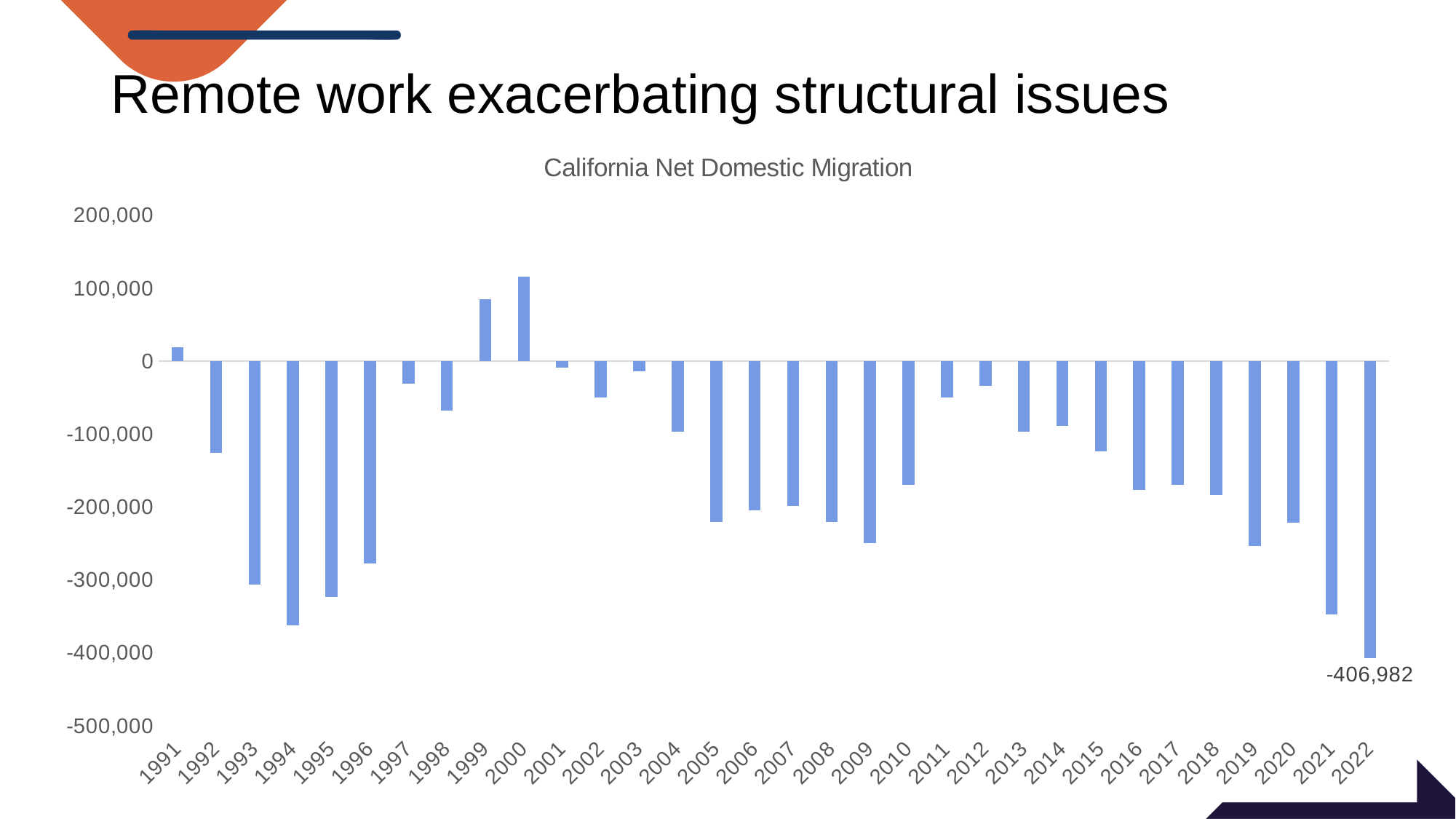
From 2012 to 2022, do the values generally rise or fall? fall Is the value for 2012 greater or less than -100,000? greater What is the title of the chart? California Net Domestic Migration What is the value for 2022? -406,982 What kind of chart is shown on the slide? bar chart Which year has the highest net domestic migration? 2000 Which year has the lower value, 2021 or 2022? 2022 Which year has the higher value, 1999 or 2000? 2000 How many years are shown on the x axis? 32 Is the value for 2000 greater or less than 100,000? greater Is the value for 1994 greater or less than -300,000? less Which year has the lowest net domestic migration? 2022